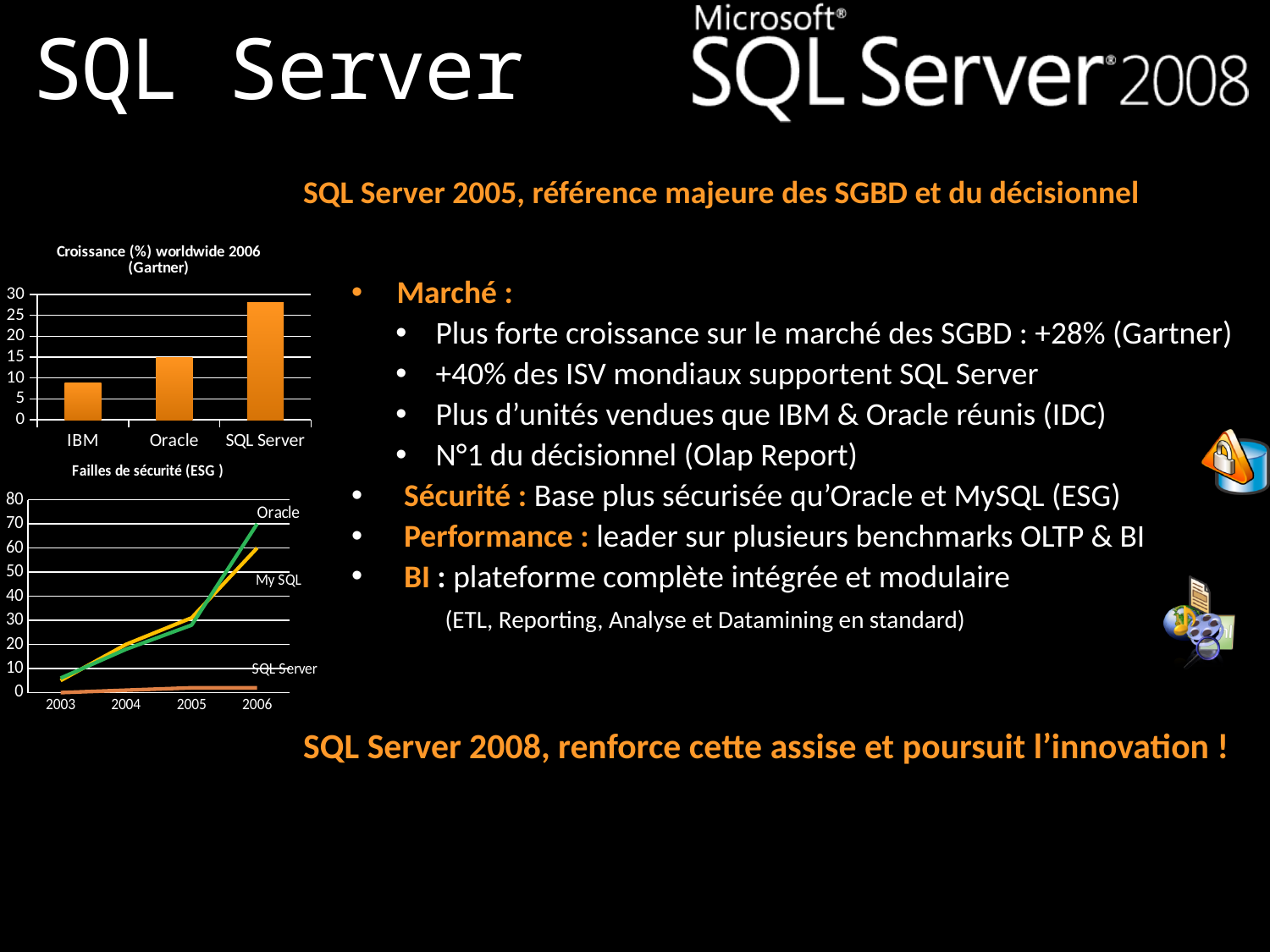
On the chart titled 'Failles de sécurité (ESG)', what kind of chart is it? line chart On the chart titled 'Failles de sécurité (ESG)', how many years are shown on the x axis? 4 On the chart titled 'Croissance (%) worldwide 2006 (Gartner)', which category has the highest value? SQL Server On the chart titled 'Croissance (%) worldwide 2006 (Gartner)', which category has the lowest value? IBM On the chart titled 'Failles de sécurité (ESG)', is the value for SQL Server in 2006 greater or less than 10? less On the chart titled 'Croissance (%) worldwide 2006 (Gartner)', how many categories are shown? 3 On the chart titled 'Failles de sécurité (ESG)', how many series are plotted? 3 On the chart titled 'Failles de sécurité (ESG)', does the Oracle line rise or fall from 2003 to 2006? rise On the chart titled 'Croissance (%) worldwide 2006 (Gartner)', is the value for SQL Server greater or less than 25? greater On the chart titled 'Croissance (%) worldwide 2006 (Gartner)', is the value for IBM greater or less than 10? less On the chart titled 'Croissance (%) worldwide 2006 (Gartner)', which is larger, the value for Oracle or the value for IBM? Oracle On the chart titled 'Croissance (%) worldwide 2006 (Gartner)', what kind of chart is it? bar chart